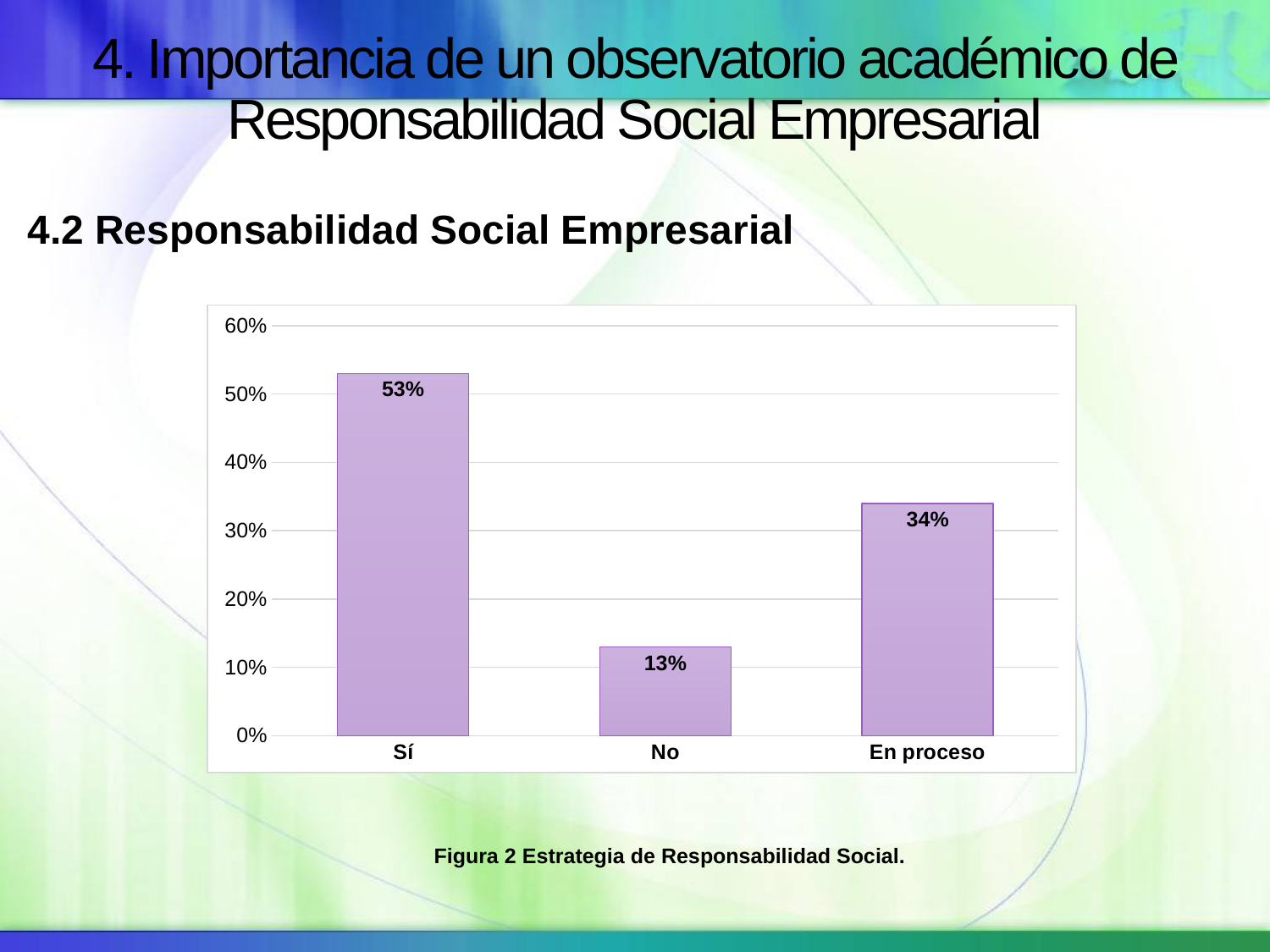
Which category has the lowest value? No Is the value for "Sí" greater or less than 50%? greater What kind of chart is shown on the slide? bar chart What is the value for "Sí"? 53% What is the difference between the values for "Sí" and "En proceso"? 19% How many categories are shown on the x axis? 3 Which category has the highest value? Sí What is the difference between the values for "En proceso" and "No"? 21% What is the caption shown below the chart? Figura 2 Estrategia de Responsabilidad Social. What is the value for "No"? 13% Which is larger, the value for "No" or the value for "En proceso"? En proceso What is the value for "En proceso"? 34%